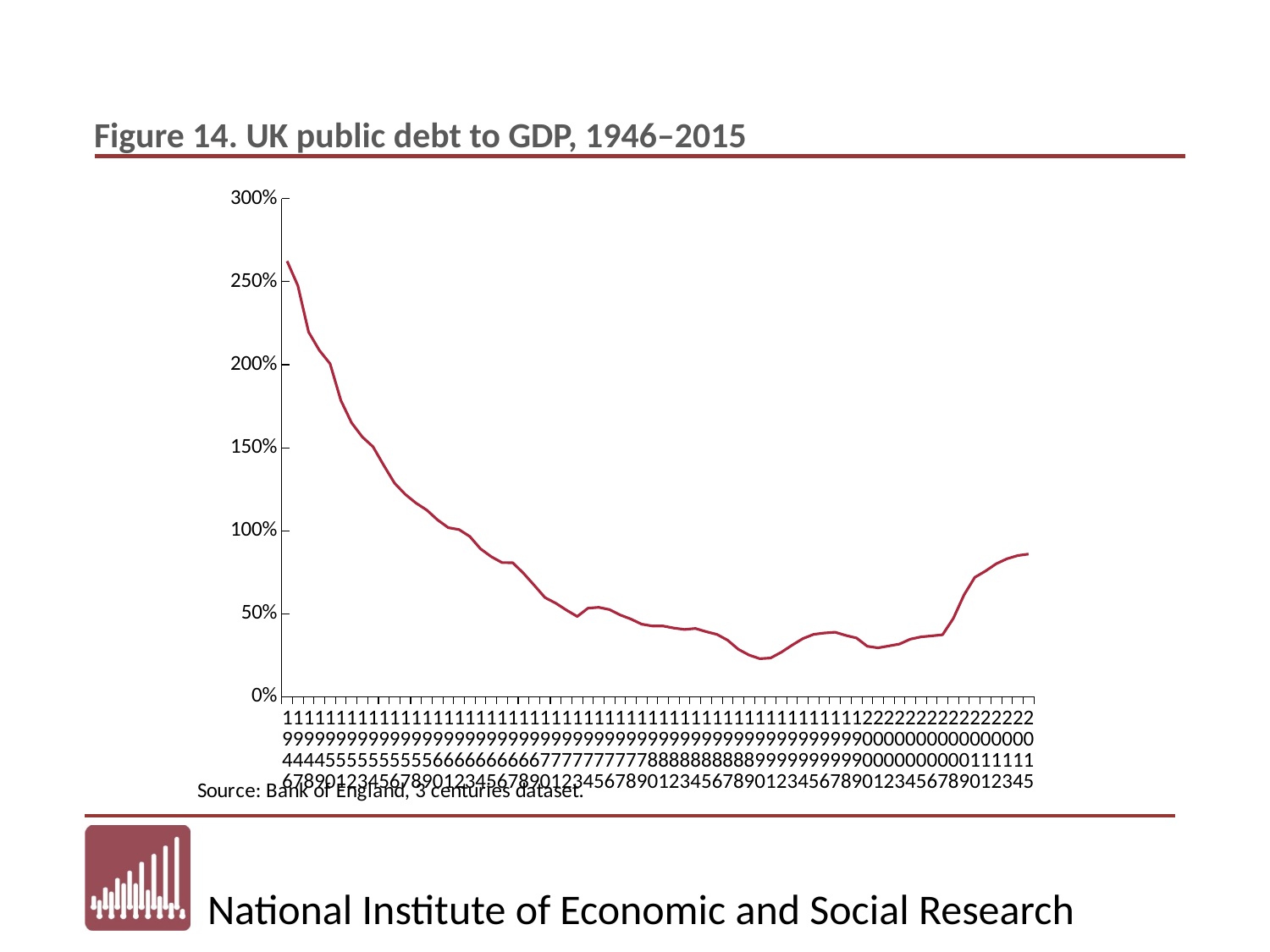
Does UK public debt to GDP rise or fall between 1946 and 1990? Fall Is the value for 1950 greater or less than 150%? greater What source is cited for the chart? Bank of England, 3 centuries dataset Is the value for 2015 greater or less than 100%? less What is the title of the chart? Figure 14. UK public debt to GDP, 1946–2015 In which year is UK public debt to GDP at its highest on the chart? 1946 Does UK public debt to GDP rise or fall between 2008 and 2015? Rise What is the highest value shown on the vertical axis? 300% What kind of chart is shown on the slide? Line chart Is the value for 1946 greater or less than 200%? greater Which year has the larger debt-to-GDP value, 1946 or 2015? 1946